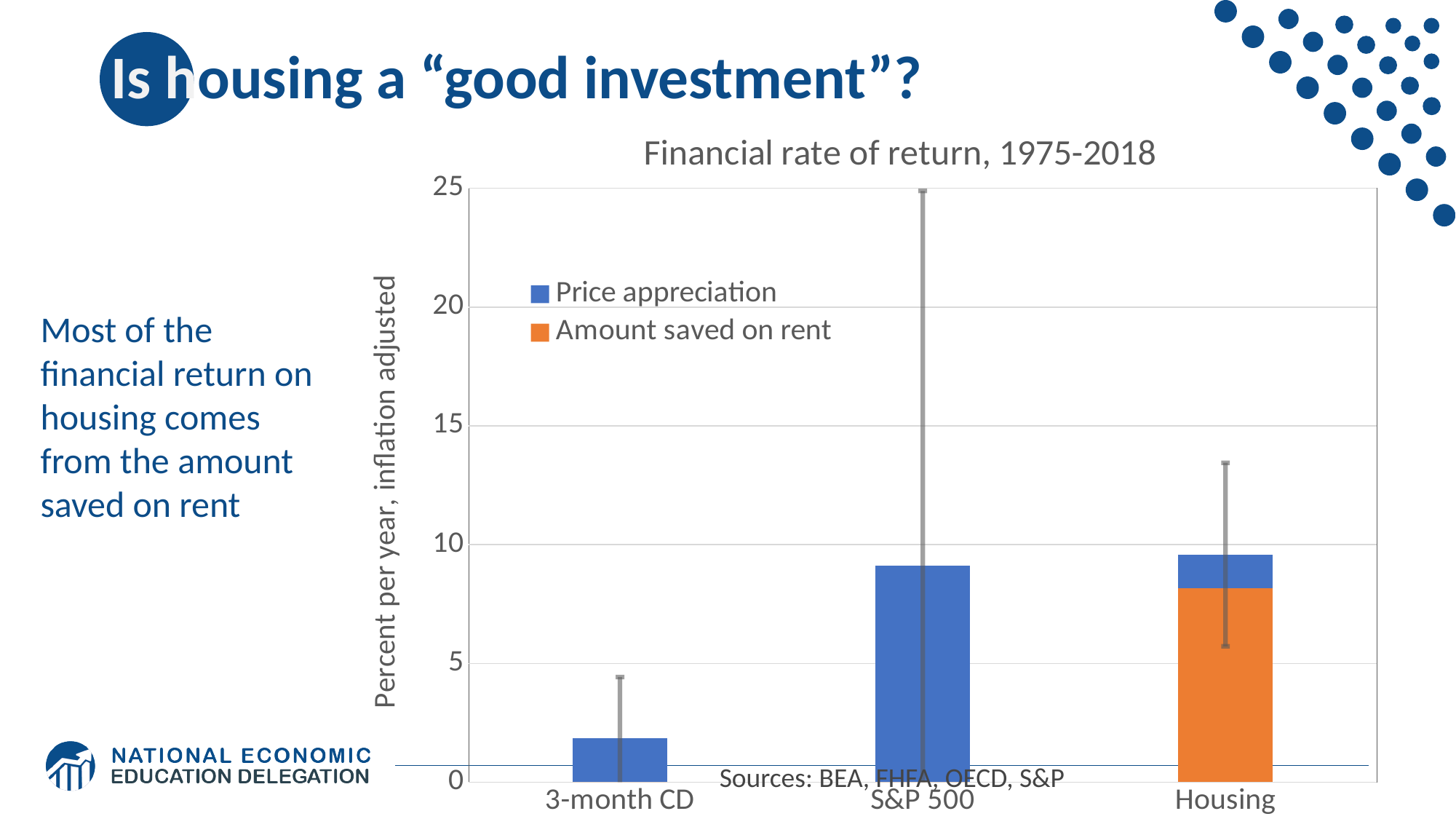
Is the total value for S&P 500 greater or less than 5? greater Which is larger, the value for 3-month CD or the value for S&P 500? S&P 500 What is the label on the y axis of the chart? Percent per year, inflation adjusted What is the title of the chart? Financial rate of return, 1975-2018 Is the total value for Housing greater or less than 5? greater Is the value for 3-month CD greater or less than 5? less Which series makes up the larger part of the Housing bar? Amount saved on rent What kind of chart is shown on the slide? Stacked bar chart How many categories are shown on the x axis of the chart? 3 Which category has the lowest total financial rate of return? 3-month CD How many series does the chart's legend list? 2